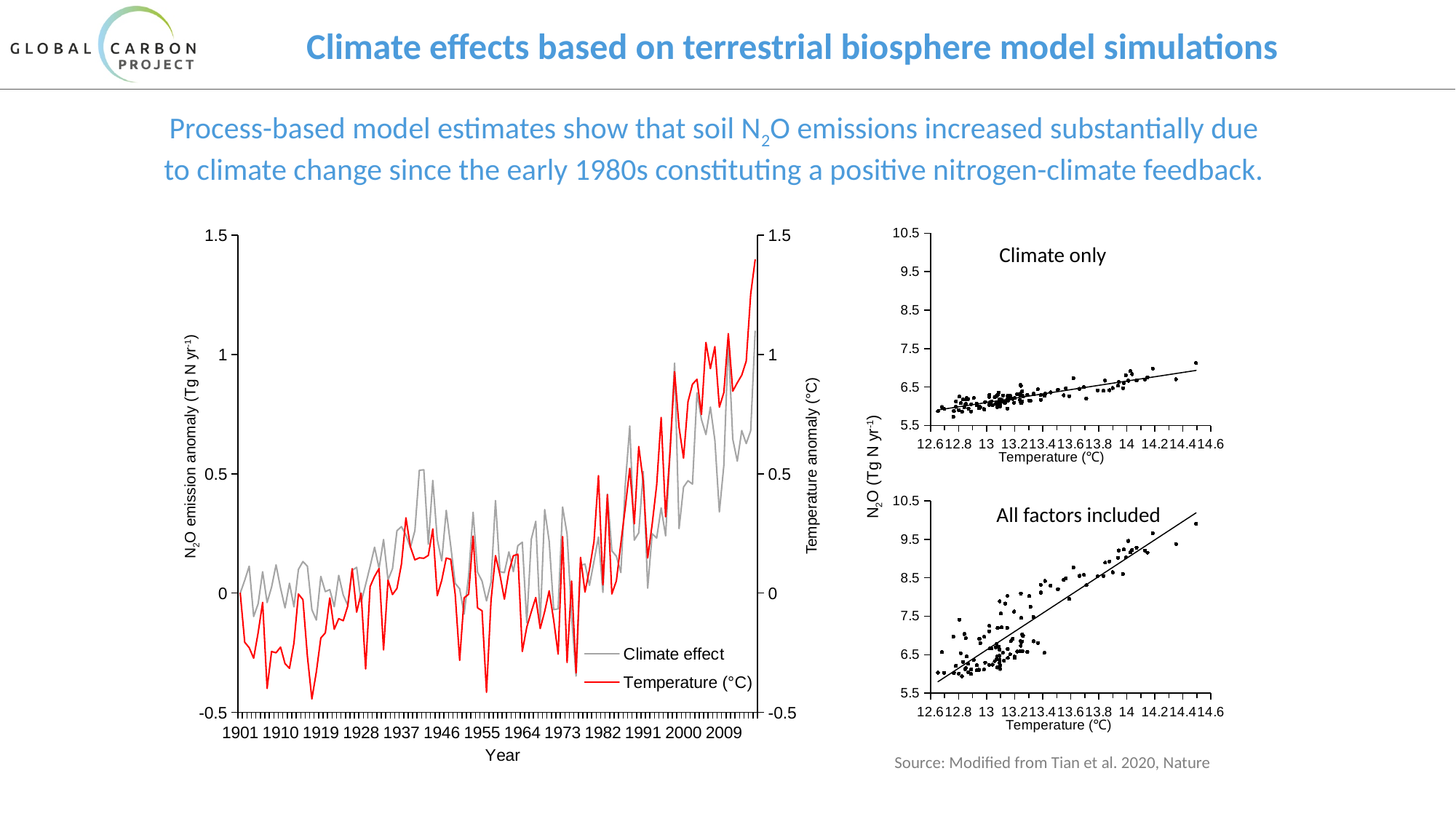
In the left line chart, at the final year, which series has the higher value: Climate effect or Temperature (°C)? Temperature (°C) In the left line chart, is the Climate effect value in 1901 greater or less than 0.5? less In the left line chart, is the Temperature (°C) value at the final year greater or less than 1? greater What kind of chart is the large chart on the left of the slide? Line chart In the left line chart, does the Climate effect series overall rise or fall from 1901 to the end of the record? Rise In the 'Climate only' chart, is the highest N2O value greater or less than 7.5? less What kind of chart is the 'Climate only' chart on the right of the slide? Scatter chart What is the x-axis label of the left line chart? Year In the 'All factors included' chart, do N2O values rise or fall as temperature increases? Rise What are the two legend entries in the left line chart? Climate effect and Temperature (°C) How many series does the legend of the left line chart list? 2